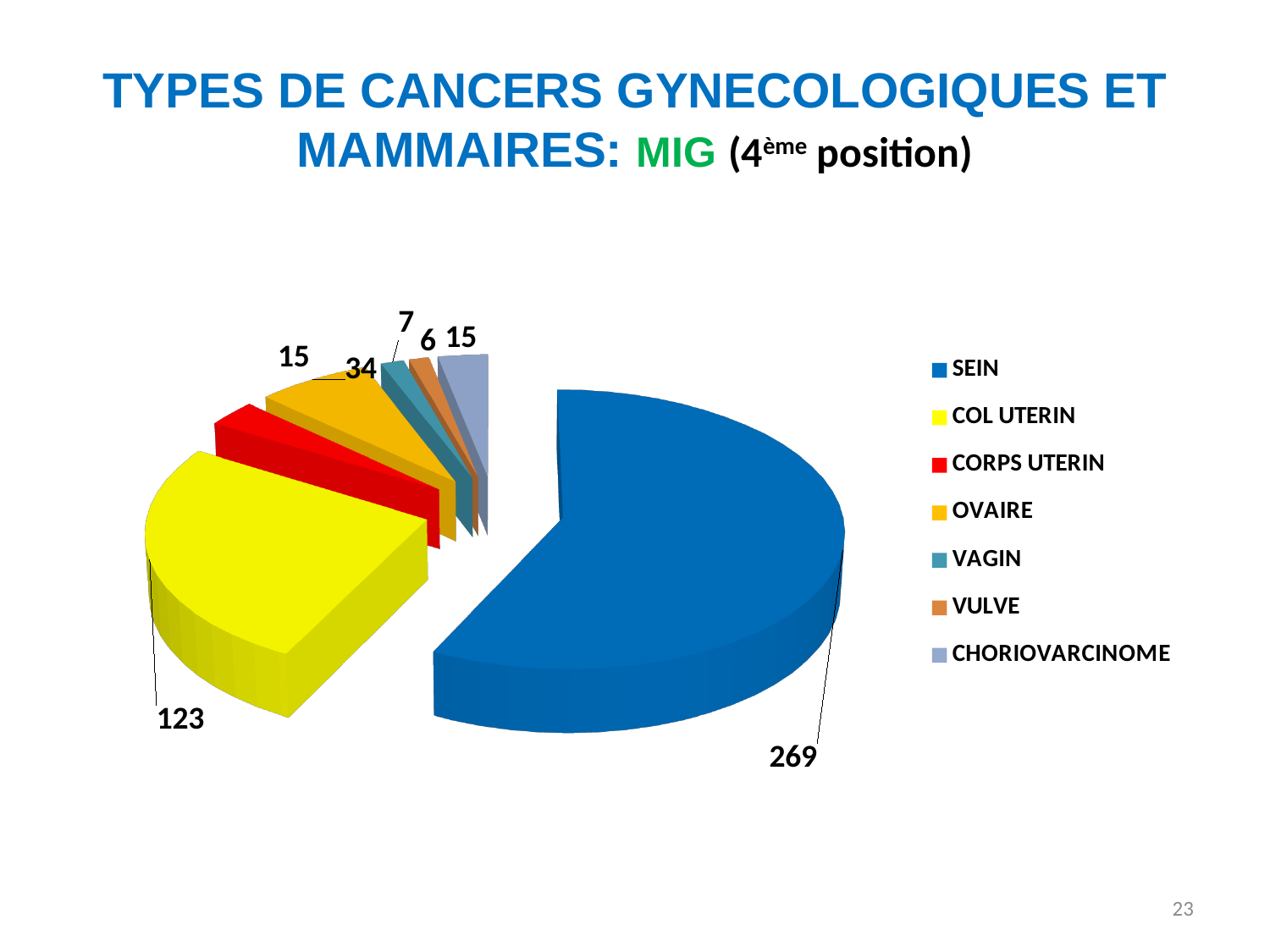
What is the total of all the slices in the pie chart? 469 What is the value for OVAIRE? 34 What is the difference between the values for SEIN and COL UTERIN? 146 Which category has the largest slice? SEIN What is the value for VAGIN? 7 What is the value for COL UTERIN? 123 What kind of chart is shown on the slide? Pie chart How many categories does the legend list? 7 Which colour represents COL UTERIN in the legend? Yellow Which category has the smallest slice? VULVE Which is larger, the value for OVAIRE or the value for CORPS UTERIN? OVAIRE What is the value for SEIN? 269